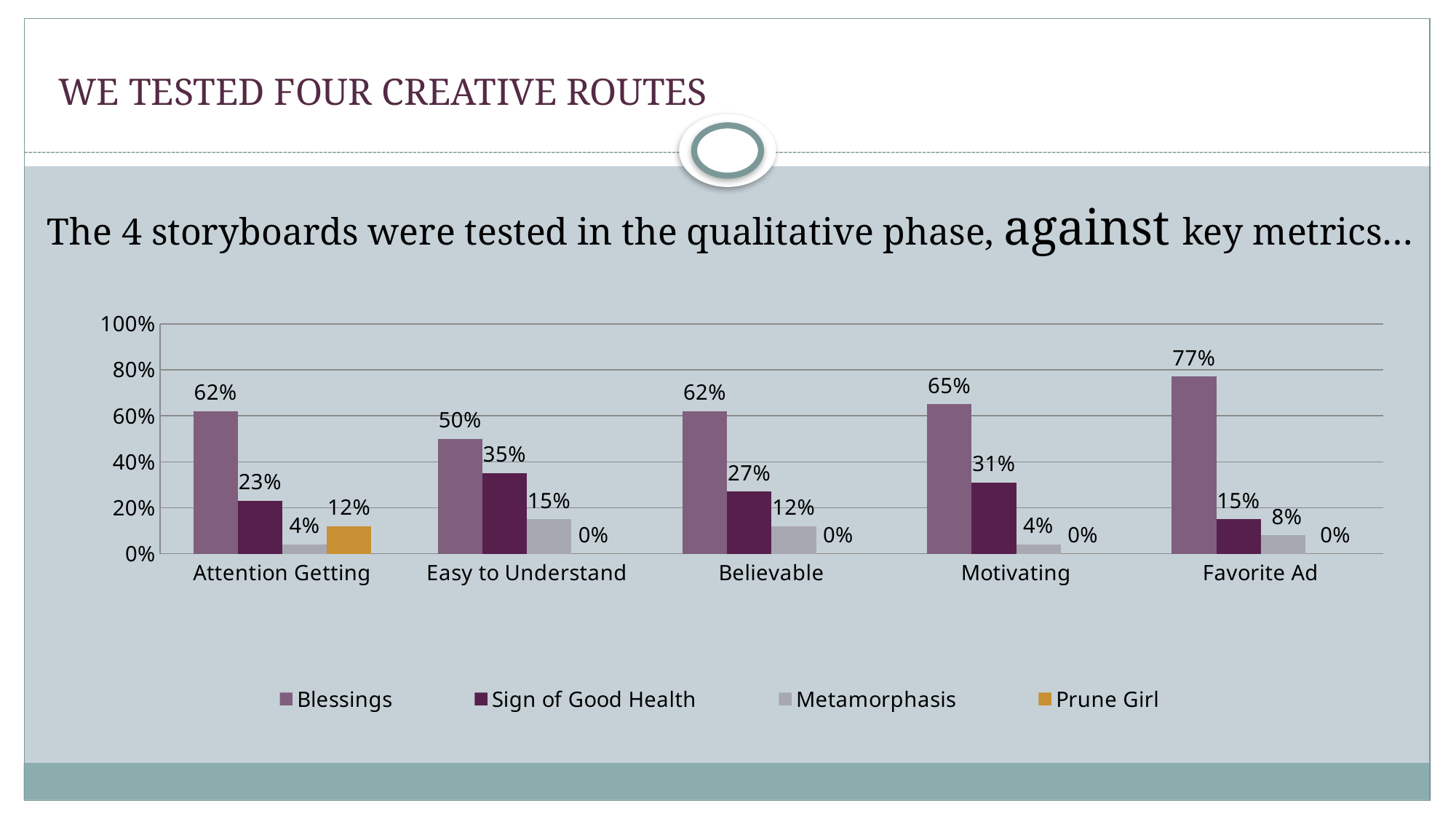
In which category does Blessings have its highest value? Favorite Ad What is the value for Blessings in the Favorite Ad category? 77% In which category does Blessings have its lowest value? Easy to Understand What is the value for Prune Girl in the Attention Getting category? 12% What is the value for Metamorphasis in the Believable category? 12% What is the value for Sign of Good Health in the Easy to Understand category? 35% How many series does the legend list? 4 Which series is shown in orange in the legend? Prune Girl How many categories are shown on the x axis? 5 What kind of chart is shown on the slide? Bar chart Which is larger in the Easy to Understand category: Sign of Good Health or Metamorphasis? Sign of Good Health What is the difference between Blessings and Sign of Good Health in the Motivating category? 34%